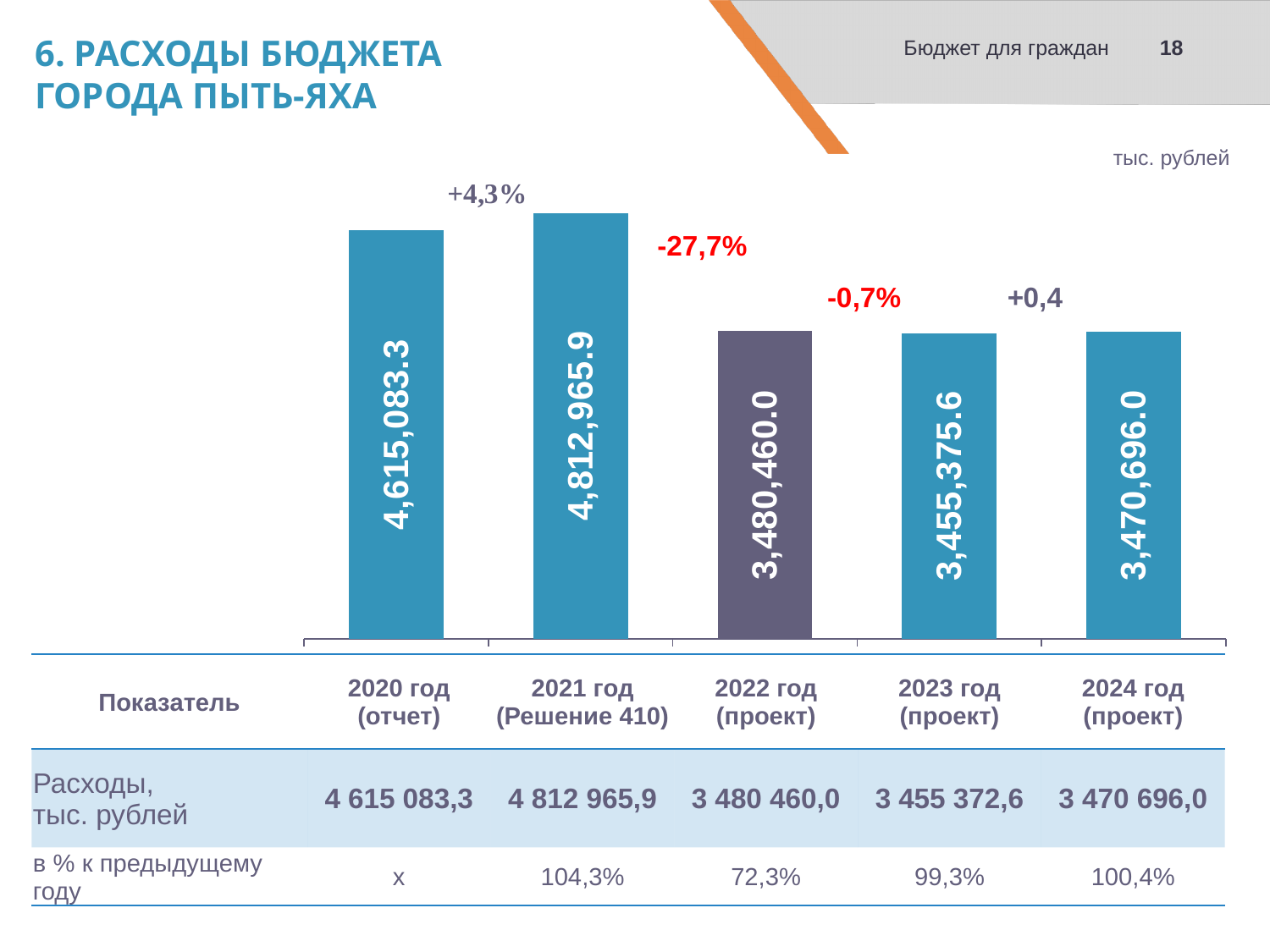
What kind of chart is shown on the slide? Bar chart What is the value of the bar for 2020 год (отчет)? 4,615,083.3 Which is larger, the bar for 2021 год or the bar for 2022 год? 2021 год What is the difference between the 2021 год bar and the 2022 год bar? 1,332,505.9 What is the value of the bar for 2024 год (проект)? 3,470,696.0 Do the values rise or fall from 2021 год to 2022 год? Fall What is the value of the bar for 2022 год (проект)? 3,480,460.0 Which year has the highest bar? 2021 год (Решение 410) What is the value of the bar for 2021 год (Решение 410)? 4,812,965.9 How many bars are shown in the chart? 5 What percentage change label is shown above the 2022 год bar? -27,7% What is the difference between the 2021 год bar and the 2020 год bar? 197,882.6